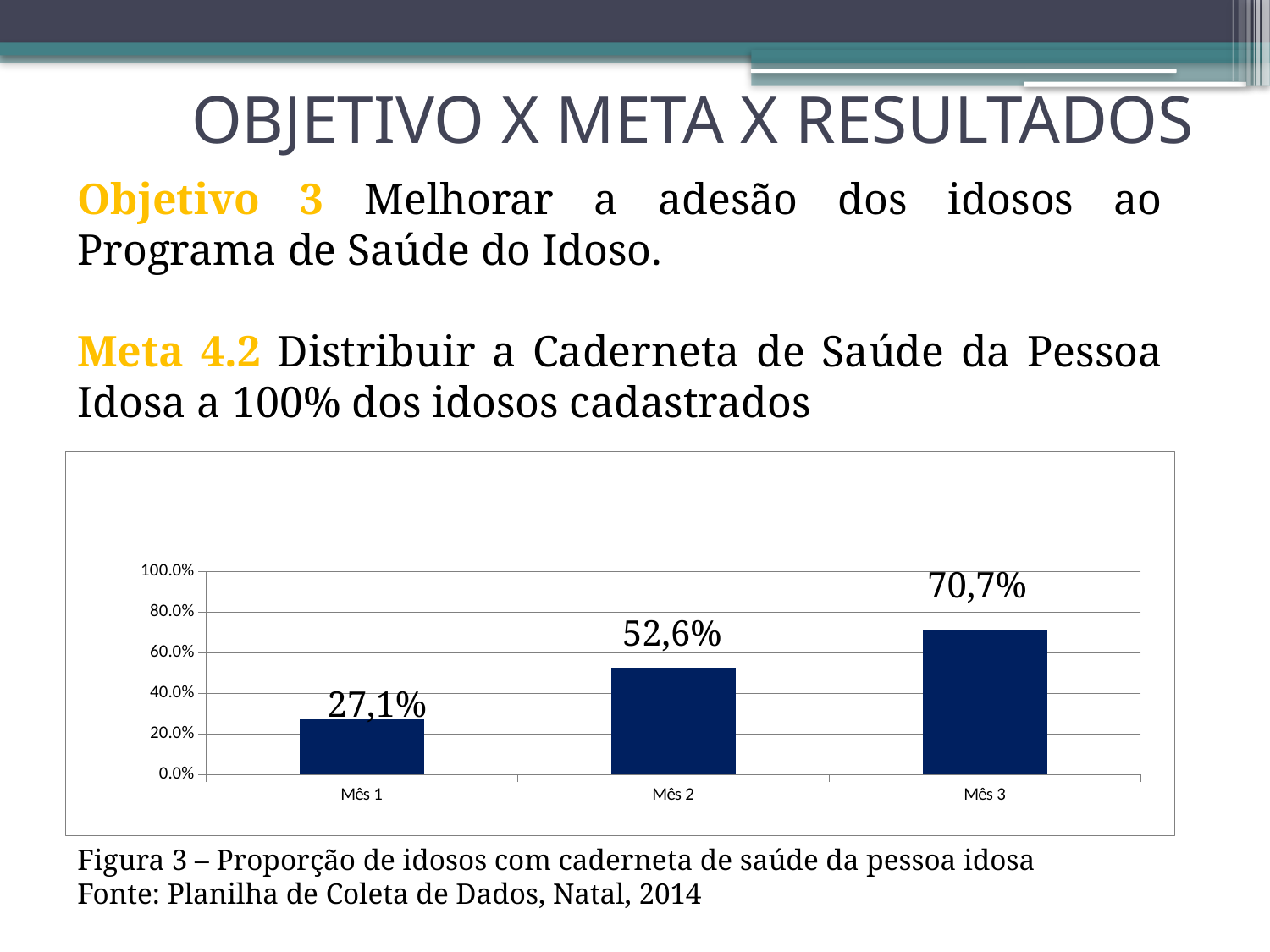
What kind of chart is shown on the slide? Bar chart Which month has the lowest value? Mês 1 How many bars are shown in the chart? 3 What is the difference between the values for Mês 3 and Mês 2? 18,1% Which is larger, the value for Mês 1 or the value for Mês 3? Mês 3 Which month has the highest value? Mês 3 What is the value for Mês 3? 70,7% What is the value for Mês 1? 27,1% What is the difference between the values for Mês 2 and Mês 1? 25,5% What is the value for Mês 2? 52,6% Is the value for Mês 2 greater or less than 40.0%? greater Do the values rise or fall from Mês 1 to Mês 3? Rise